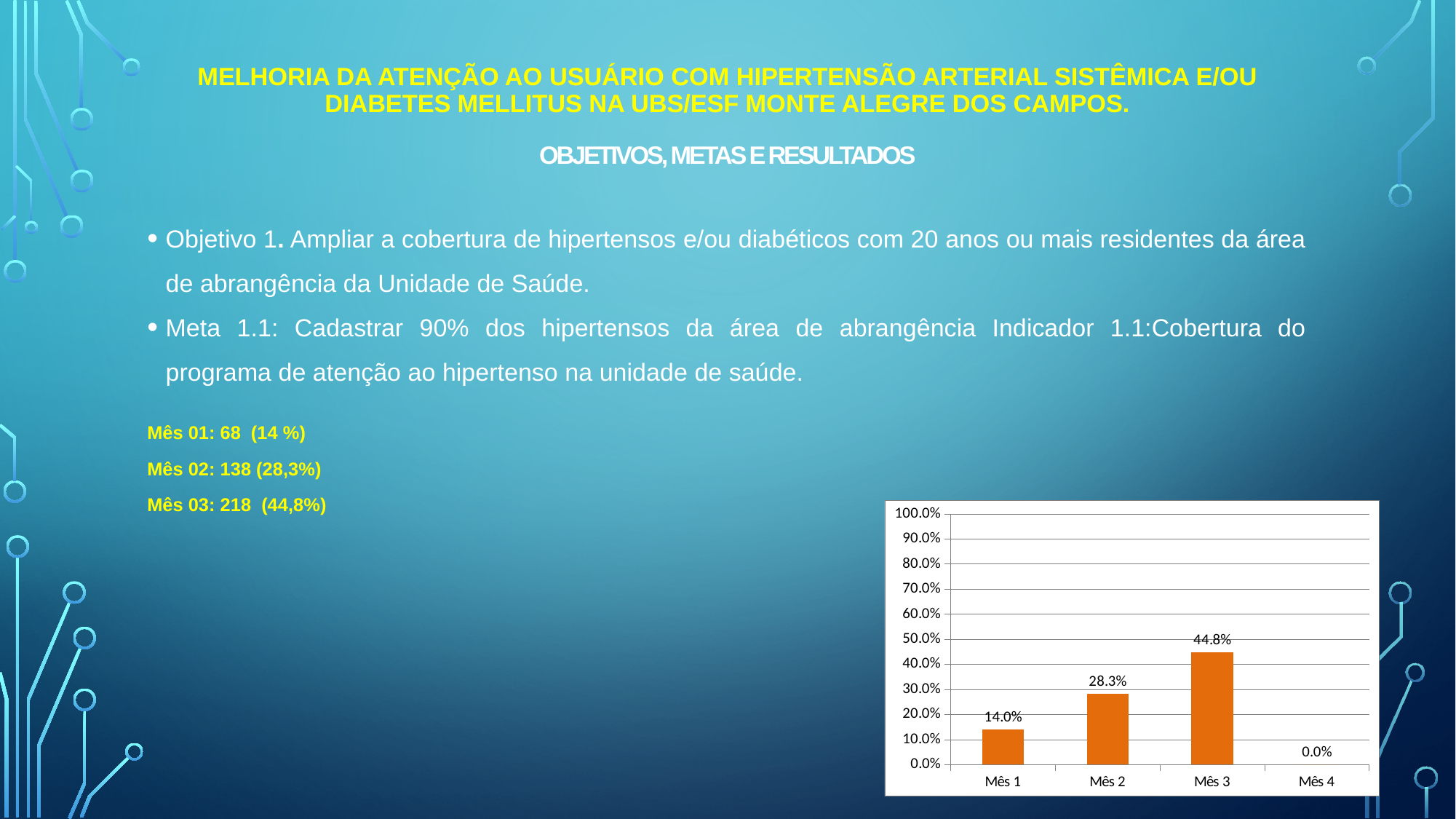
What is the value for Mês 1 in the chart? 14.0% What kind of chart is shown on the slide? Bar chart What is the value for Mês 4 in the chart? 0.0% How many months (categories) are shown on the x axis of the chart? 4 Do the values rise or fall from Mês 1 to Mês 3? Rise What is the difference between the values for Mês 2 and Mês 1? 14.3% Which is larger, the value for Mês 1 or the value for Mês 2? Mês 2 What is the value for Mês 2 in the chart? 28.3% What is the value for Mês 3 in the chart? 44.8% Which month has the lowest value in the chart? Mês 4 Which month has the highest value in the chart? Mês 3 What is the difference between the values for Mês 3 and Mês 2? 16.5%